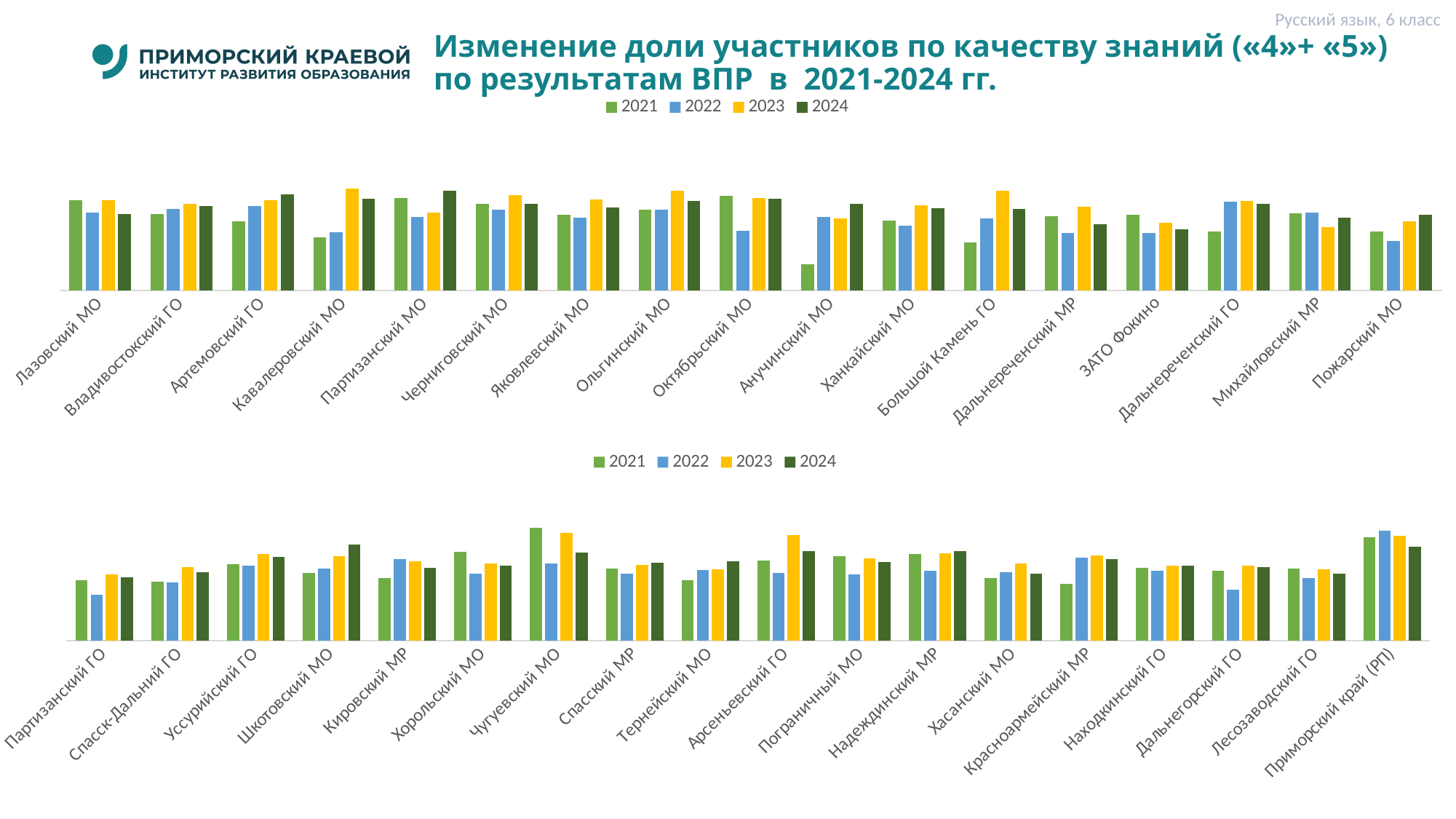
In the top chart, which year has the highest bar for Кавалеровский МО? 2023 How many categories (municipalities) are shown on the x axis of the top chart? 17 How many series does the legend of the top chart list? 4 In the bottom chart, do the bars for Шкотовский МО rise or fall from 2021 to 2024? rise Which years are listed in the legend of the bottom chart? 2021, 2022, 2023, 2024 How many categories are shown on the x axis of the bottom chart? 18 In the top chart, which is larger for Анучинский МО: the 2021 bar or the 2024 bar? 2024 In the top chart, which year has the lowest bar for Анучинский МО? 2021 What kind of chart is the top chart on the slide? bar chart In the bottom chart, which year has the highest bar for Арсеньевский ГО? 2023 In the top chart, which year has the lowest bar for Большой Камень ГО? 2021 In the bottom chart, which year has the lowest bar for Дальнегорский ГО? 2022